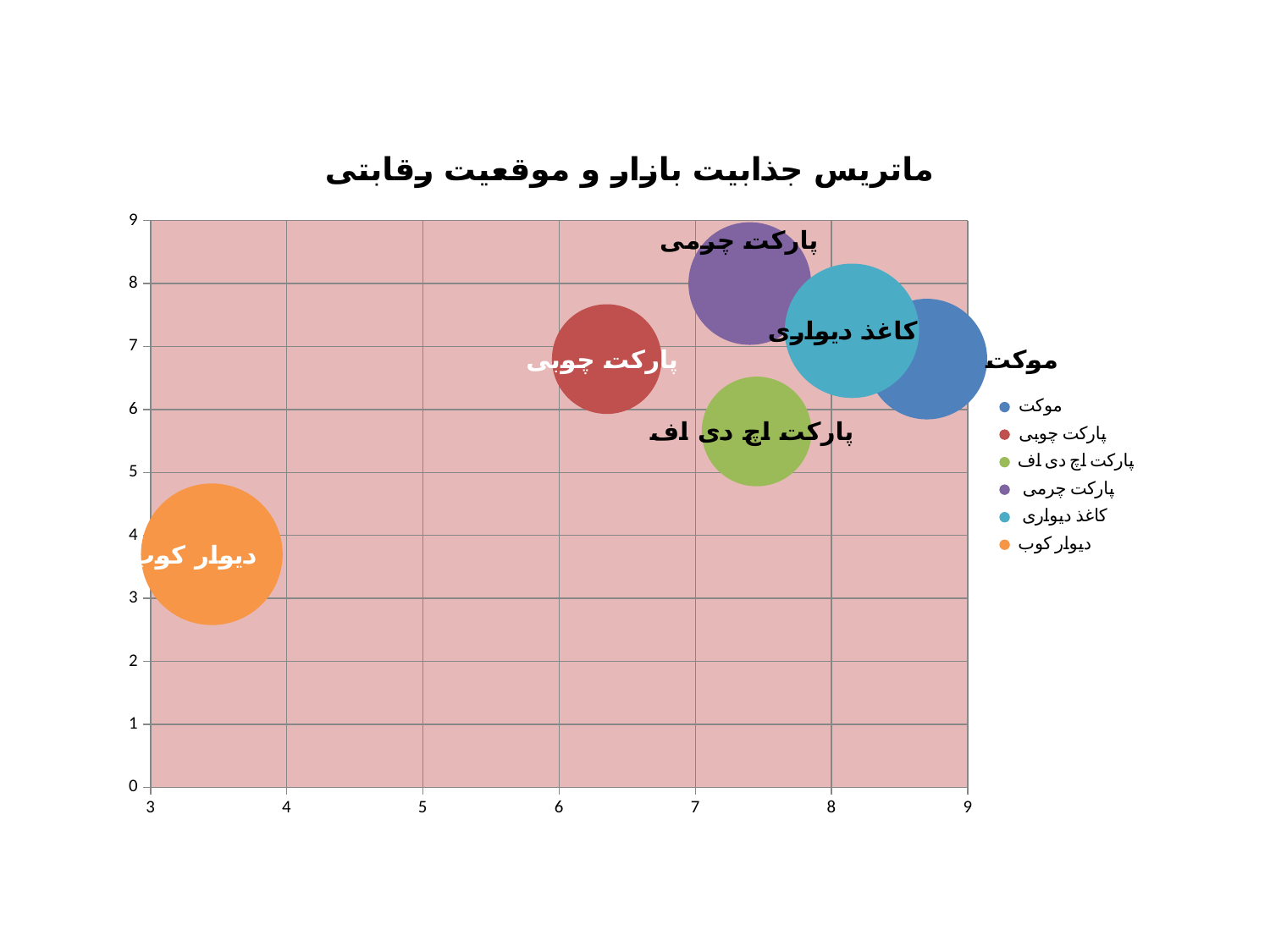
Is the vertical-axis value for دیوار کوب greater or less than 5? less What is the title of the chart? ماتریس جذابیت بازار و موقعیت رقابتی Which bubble is lowest on the vertical axis? دیوار کوب Which bubble is furthest to the left on the horizontal axis? دیوار کوب What kind of chart is shown on the slide? Bubble chart How many bubbles are plotted on the chart? 6 Which bubble is furthest to the right on the horizontal axis? موکت Is the horizontal-axis value for موکت greater or less than 8? greater Which bubble is highest on the vertical axis? پارکت چرمی How many series does the legend list? 6 Which is higher on the vertical axis, پارکت چرمی or پارکت اچ دی اف? پارکت چرمی Is the horizontal-axis value for پارکت چوبی greater or less than 7? less